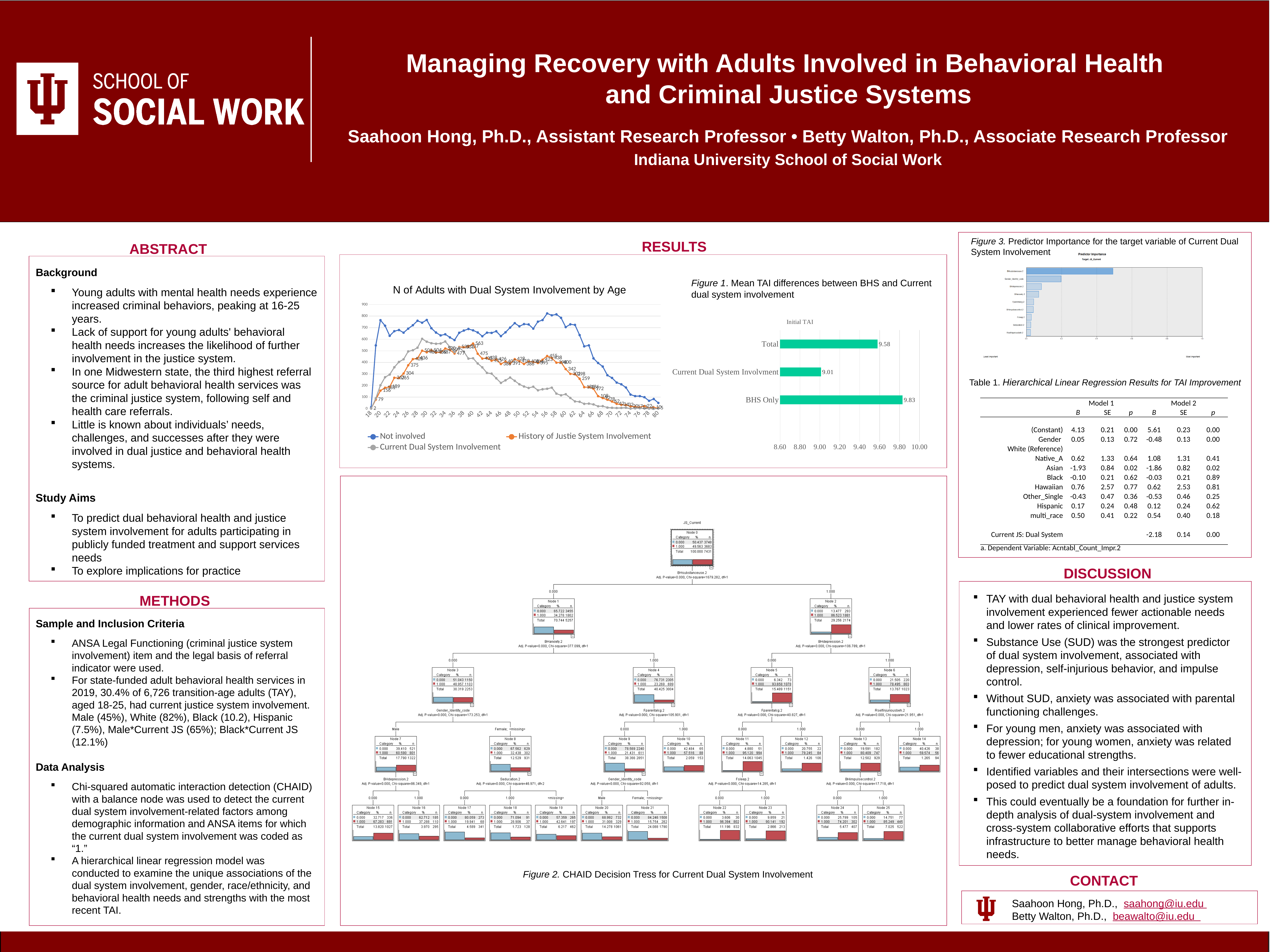
In Figure 1 (Initial TAI), how many categories are plotted? 3 In the chart 'N of Adults with Dual System Involvement by Age', does the Not involved series rise or fall between age 60 and age 80? fall In the chart 'N of Adults with Dual System Involvement by Age', is the value for the Current Dual System Involvement series at age 80 greater or less than 100? less In Figure 1 (Initial TAI), which category has the lowest value? Current Dual System Involvment In Figure 1 (Initial TAI), which category has the highest value? BHS Only In Figure 1 (Initial TAI), what is the value for Current Dual System Involvment? 9.01 In the chart 'N of Adults with Dual System Involvement by Age', how many series does the legend list? 3 In Figure 1 (Initial TAI), what is the value for BHS Only? 9.83 What kind of chart is Figure 1 (Mean TAI differences between BHS and Current dual system involvement)? bar chart What kind of chart is 'N of Adults with Dual System Involvement by Age'? line chart In Figure 1 (Initial TAI), what is the difference between the BHS Only value and the Current Dual System Involvment value? 0.82 In Figure 1 (Initial TAI), what is the value for Total? 9.58